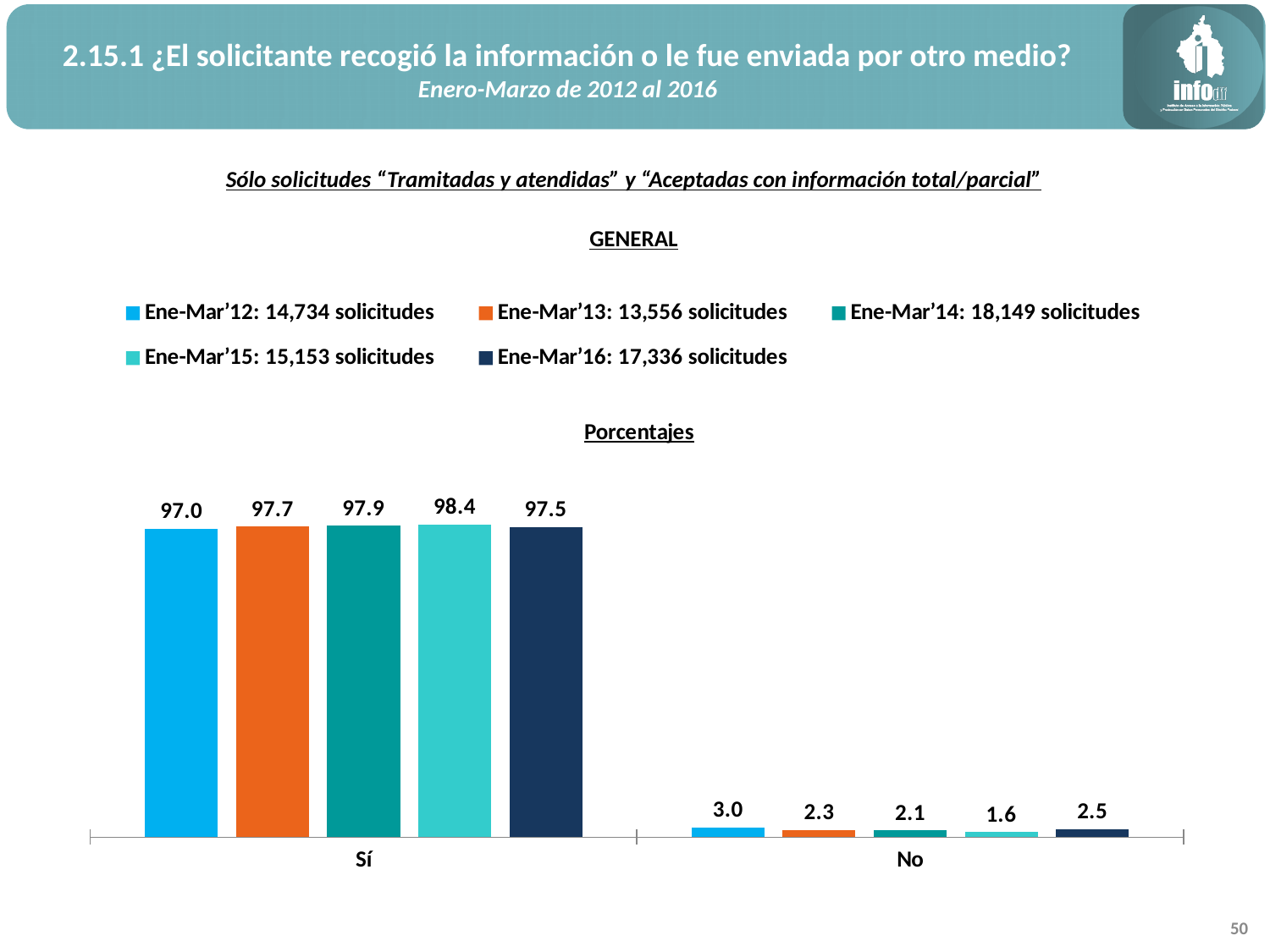
Which series has the lowest value in the No category? Ene-Mar'15 How many categories are shown on the x axis? 2 What is the difference between the Ene-Mar'12 and Ene-Mar'13 values in the No category? 0.7 According to the legend, how many solicitudes does Ene-Mar'14 correspond to? 18,149 solicitudes What is the value for Ene-Mar'16 in the Sí category? 97.5 Which series has the highest value in the Sí category? Ene-Mar'15 What kind of chart is shown on the slide? Bar chart Which series has the highest value in the No category? Ene-Mar'12 What is the value for Ene-Mar'15 in the No category? 1.6 Which is larger in the Sí category: Ene-Mar'14 or Ene-Mar'16? Ene-Mar'14 How many series does the legend list? 5 What is the value for Ene-Mar'12 in the Sí category? 97.0